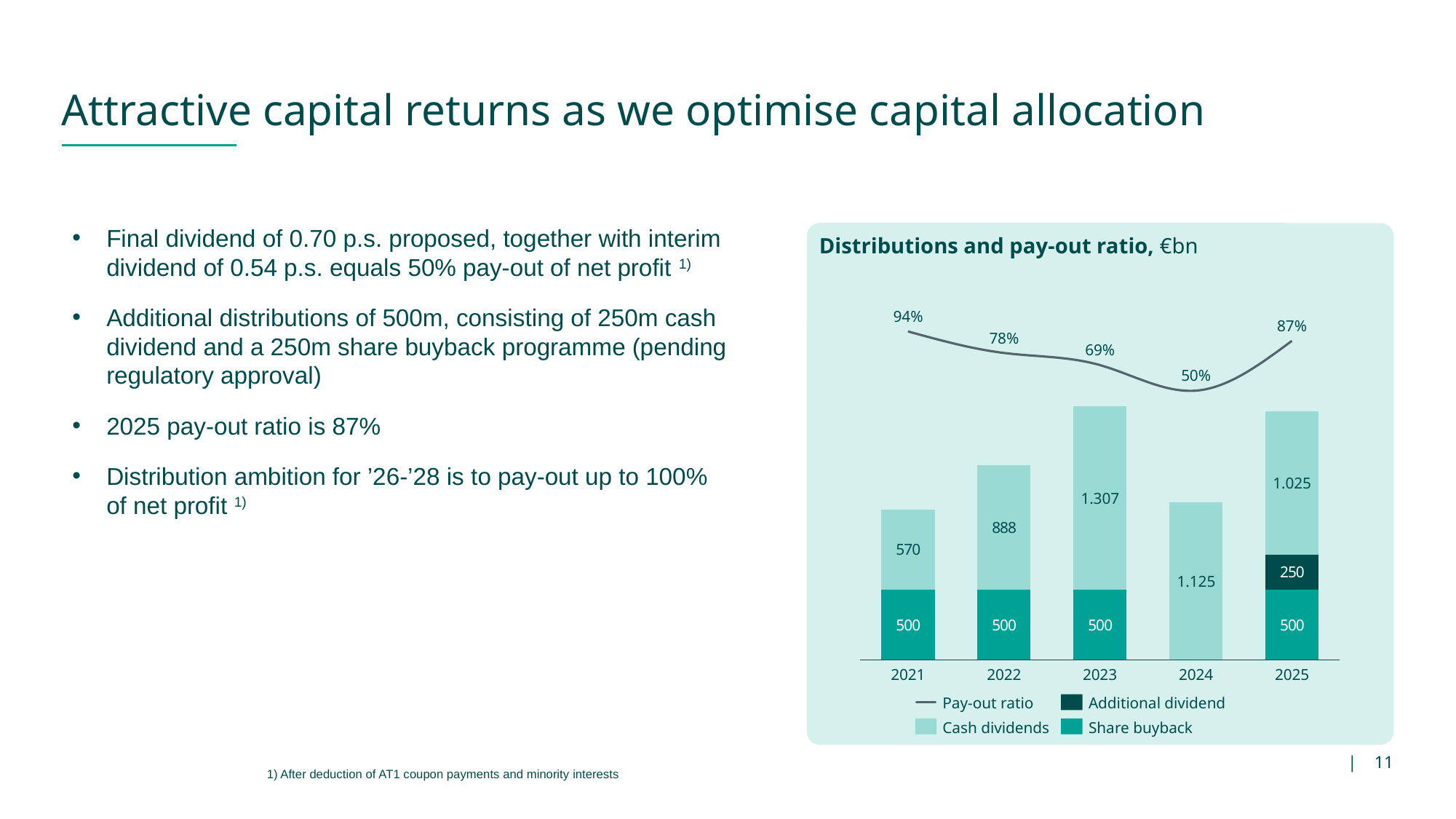
How many years are shown on the x axis? 5 Which year has the lowest pay-out ratio? 2024 How many series does the legend list? 4 What is the additional dividend value shown for 2025? 250 What is the total of the stacked bar for 2025? 1.775 What is the pay-out ratio for 2021? 94% Does the pay-out ratio rise or fall from 2021 to 2024? fall Is the pay-out ratio higher in 2025 or in 2023? 2025 What is the difference between the cash dividends in 2022 and 2021? 318 Which year has the highest cash dividends value? 2023 What is the cash dividends value for 2023? 1.307 What is the share buyback value for 2022? 500